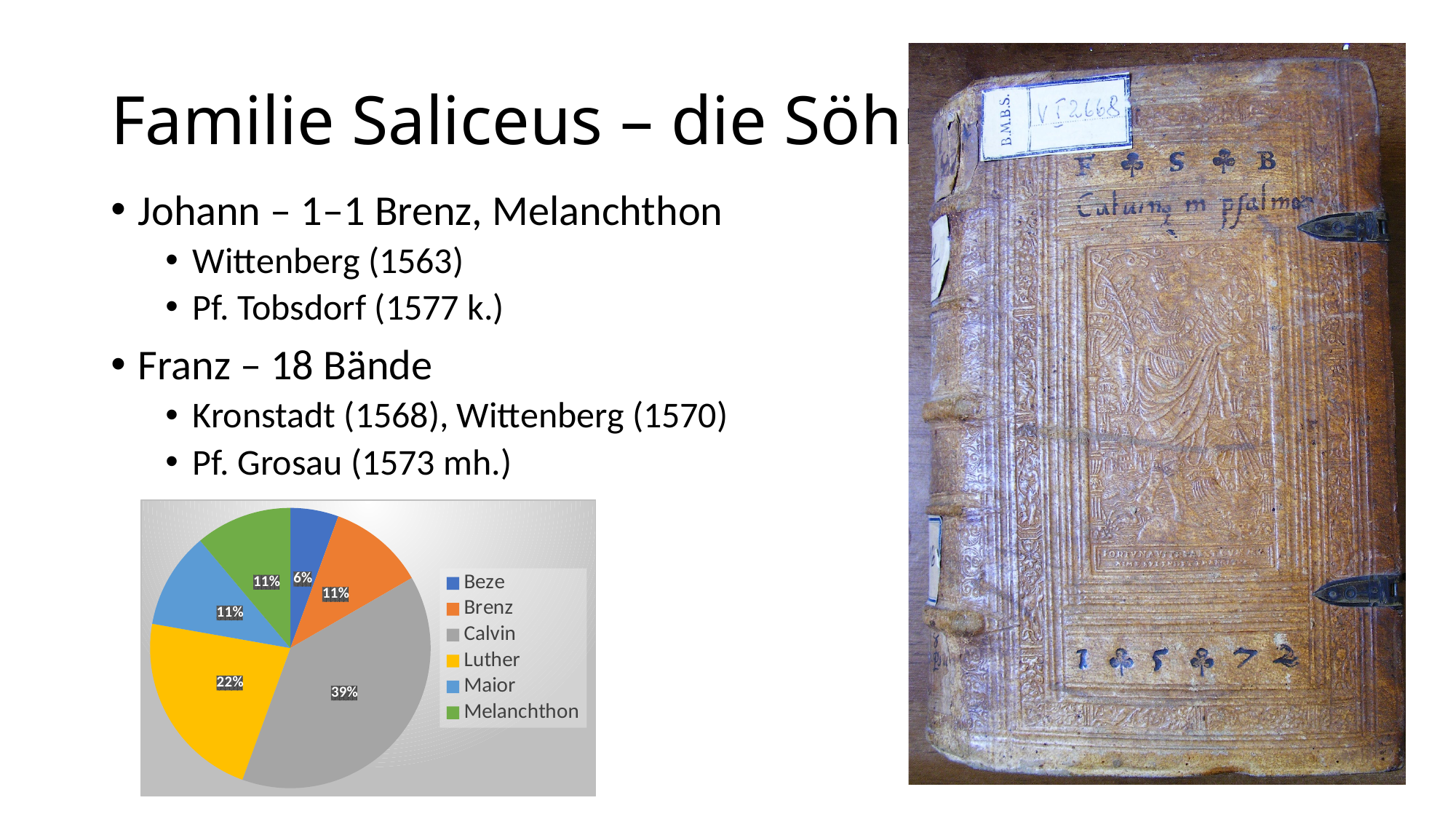
What is the difference in percentage points between the Calvin slice and the Luther slice? 17 Which slice is larger in the pie chart, Luther or Brenz? Luther What share of the pie chart does Calvin have? 39% What share of the pie chart does Beze have? 6% Which category has the largest slice in the pie chart? Calvin Which category has the smallest slice in the pie chart? Beze How many categories does the pie chart show? 6 Which category is listed first in the pie chart's legend? Beze What kind of chart is shown on the slide? pie chart What share of the pie chart does Brenz have? 11% Which colour represents Melanchthon in the pie chart? green